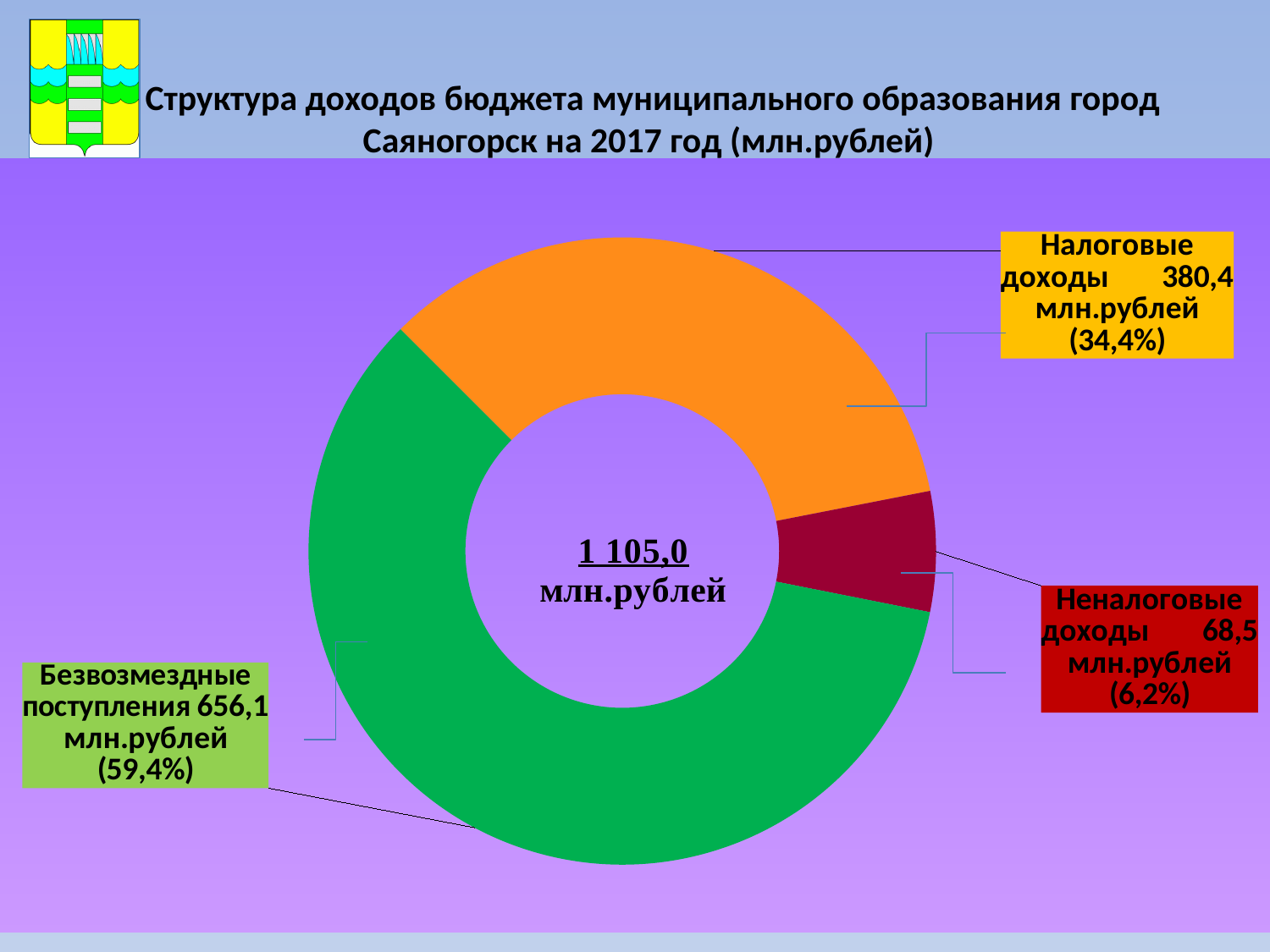
What is the value for Налоговые доходы? 380,4 млн.рублей What total value is shown in the centre of the chart? 1 105,0 млн.рублей Which is larger, Налоговые доходы or Неналоговые доходы? Налоговые доходы What is the value for Безвозмездные поступления? 656,1 млн.рублей How many segments does the chart have? 3 What share of the total do Безвозмездные поступления make up? 59,4% What is the value for Неналоговые доходы? 68,5 млн.рублей What is the difference between Безвозмездные поступления and Налоговые доходы? 275,7 млн.рублей Which category has the largest value? Безвозмездные поступления What share of the total do Налоговые доходы make up? 34,4% Which category has the smallest value? Неналоговые доходы What kind of chart is shown on the slide? Pie (donut) chart